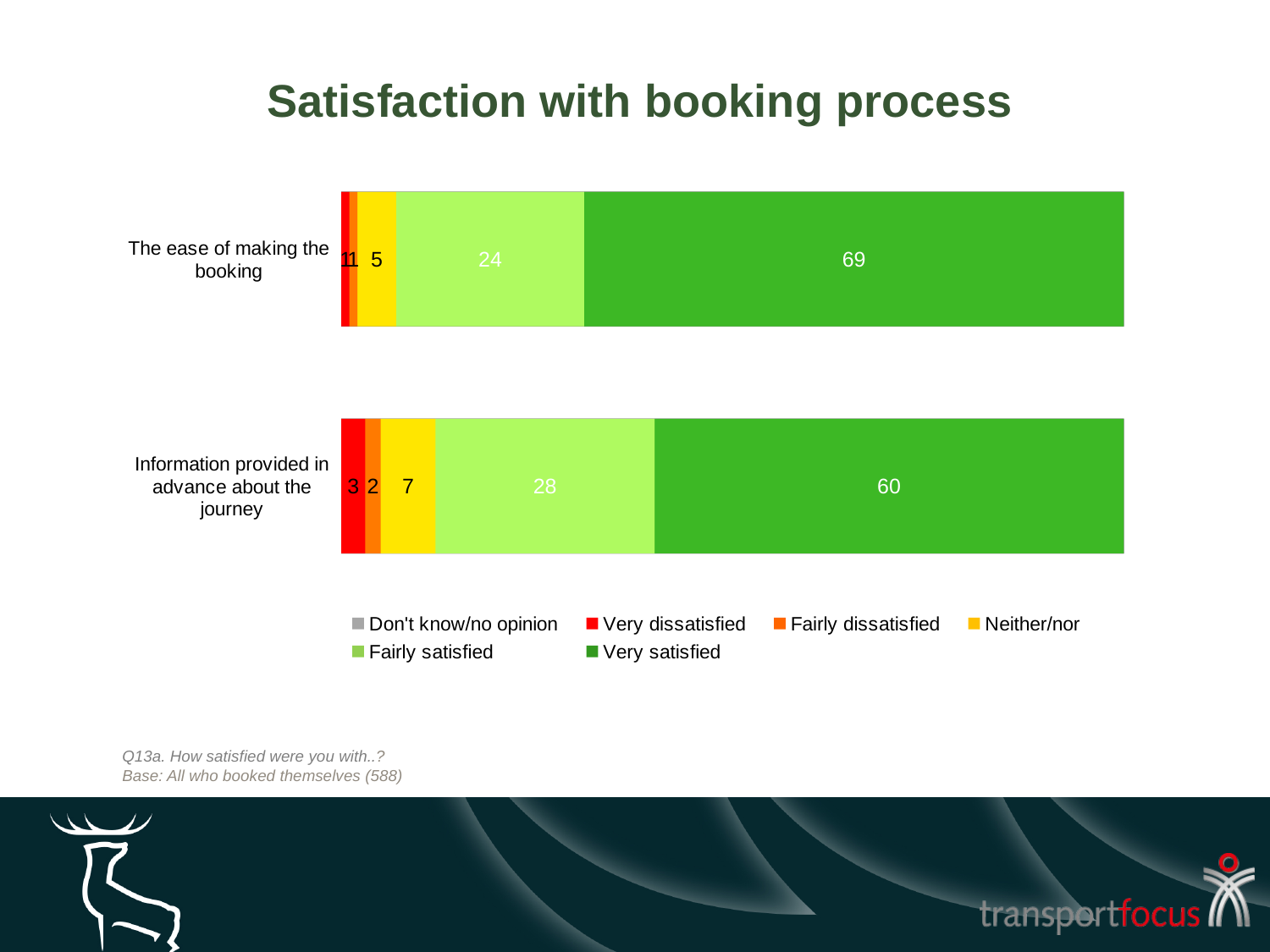
What is the Fairly dissatisfied value for 'Information provided in advance about the journey'? 2 Is the Fairly satisfied value larger for 'The ease of making the booking' or for 'Information provided in advance about the journey'? Information provided in advance about the journey What is the difference between the Very satisfied values for 'The ease of making the booking' and 'Information provided in advance about the journey'? 9 What is the Fairly satisfied value for 'Information provided in advance about the journey'? 28 What is the Neither/nor value for 'The ease of making the booking'? 5 What is the Very dissatisfied value for 'Information provided in advance about the journey'? 3 What is the Very satisfied value for 'The ease of making the booking'? 69 What kind of chart is shown on the slide? Stacked bar chart How many series does the legend list? 6 Which category has the higher Very satisfied value? The ease of making the booking How many categories are shown in the chart? 2 What is the total of the stacked bar for 'Information provided in advance about the journey'? 100